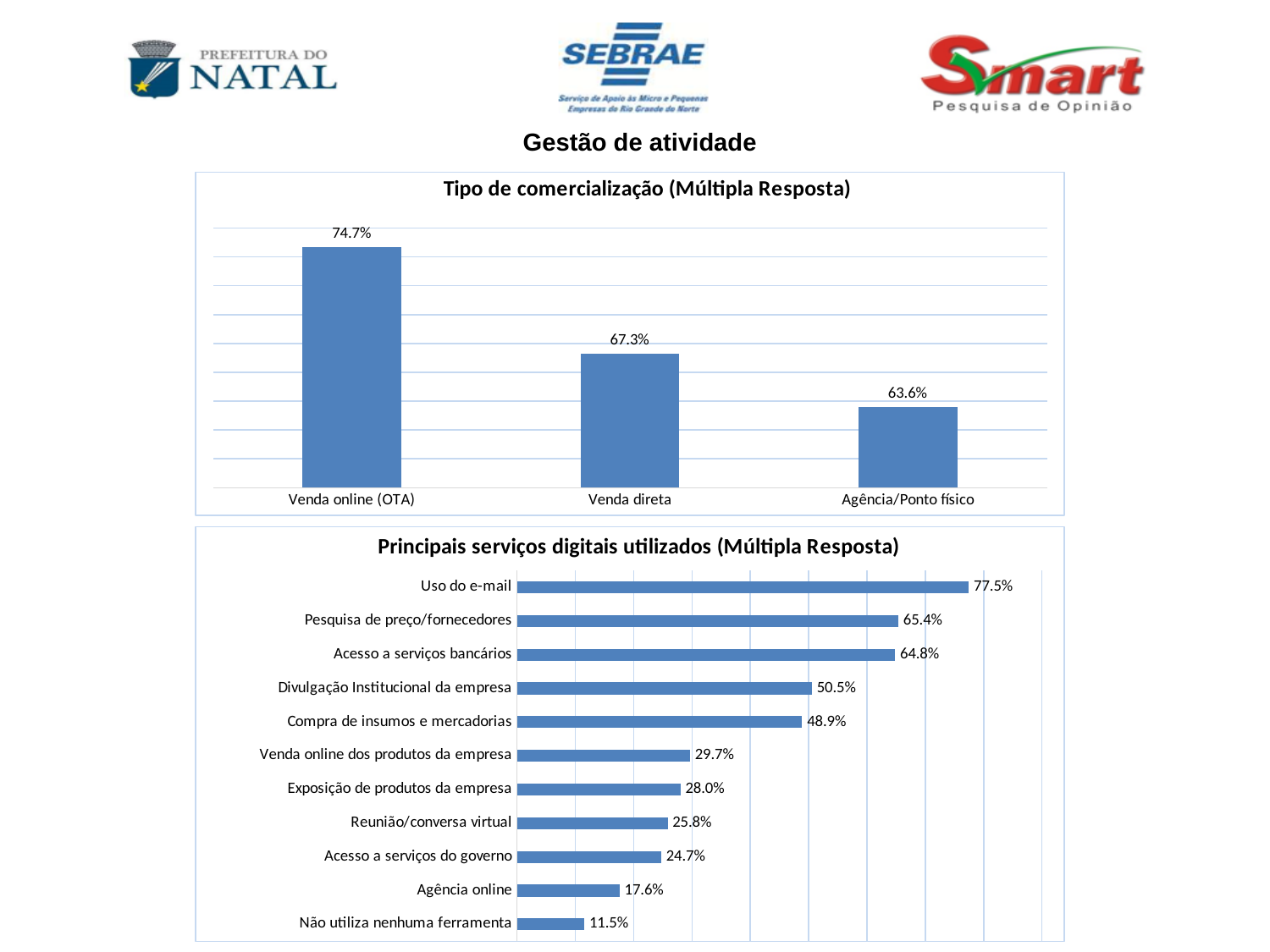
In the 'Principais serviços digitais utilizados (Múltipla Resposta)' chart, which category has the lowest value? Não utiliza nenhuma ferramenta In the 'Tipo de comercialização (Múltipla Resposta)' chart, which category has the lowest value? Agência/Ponto físico In the 'Tipo de comercialização (Múltipla Resposta)' chart, which category has the highest value? Venda online (OTA) In the 'Principais serviços digitais utilizados (Múltipla Resposta)' chart, what is the value for Agência online? 17.6% In the 'Principais serviços digitais utilizados (Múltipla Resposta)' chart, which category has the highest value? Uso do e-mail In the 'Principais serviços digitais utilizados (Múltipla Resposta)' chart, which is larger: Divulgação Institucional da empresa or Compra de insumos e mercadorias? Divulgação Institucional da empresa In the 'Principais serviços digitais utilizados (Múltipla Resposta)' chart, how many categories are shown? 11 In the 'Principais serviços digitais utilizados (Múltipla Resposta)' chart, what is the value for Acesso a serviços bancários? 64.8% In the 'Tipo de comercialização (Múltipla Resposta)' chart, how many categories are shown? 3 In the 'Tipo de comercialização (Múltipla Resposta)' chart, do the values rise or fall from left to right? fall In the 'Tipo de comercialização (Múltipla Resposta)' chart, what is the difference between Venda online (OTA) and Agência/Ponto físico? 11.1% In the 'Tipo de comercialização (Múltipla Resposta)' chart, what is the value for Venda direta? 67.3%